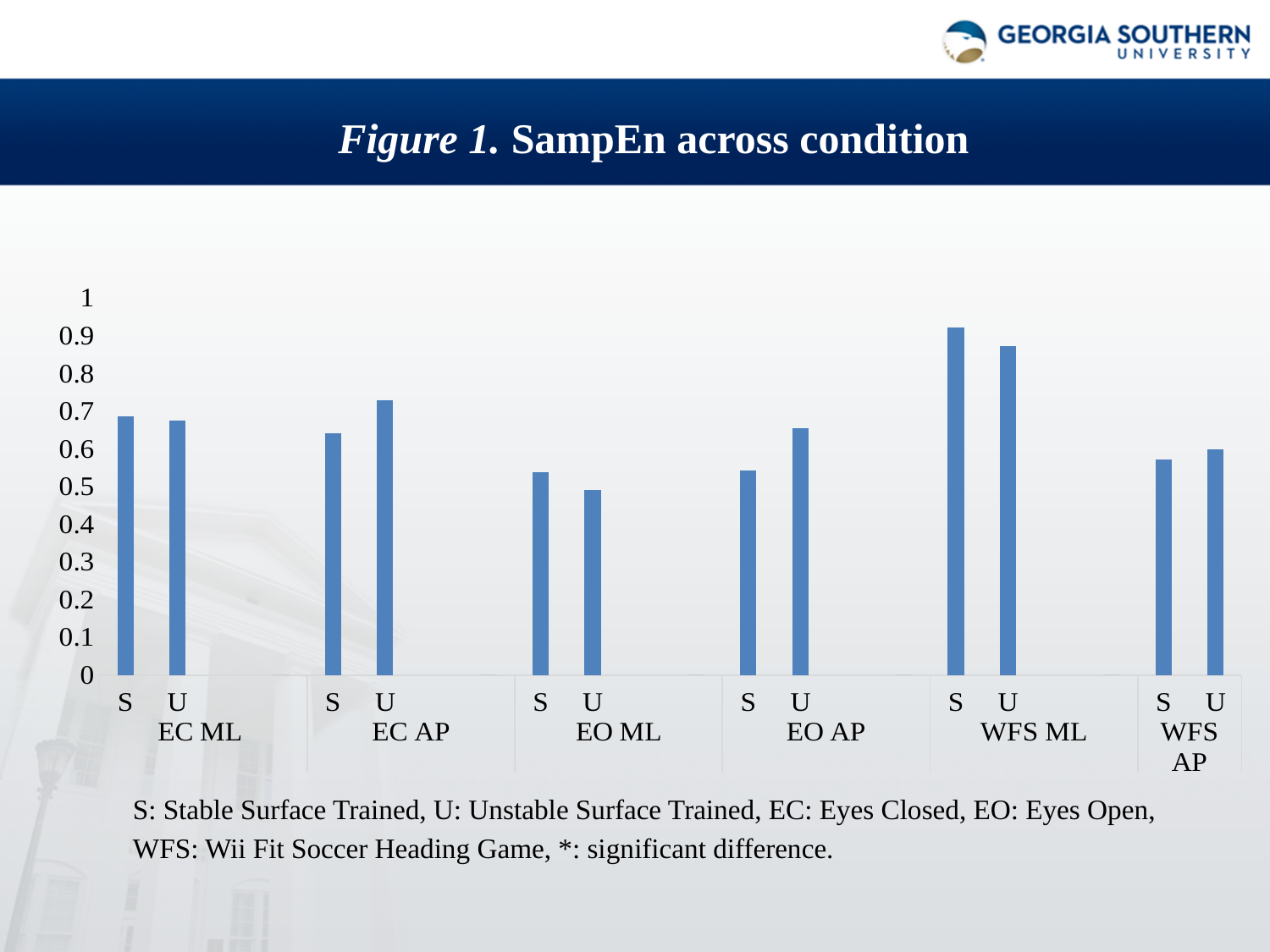
Is the value for EC AP U greater or less than 0.6? greater According to the note below the chart, what does S stand for? Stable Surface Trained How many bars are plotted in the chart? 12 Which bar has the lowest SampEn value? EO ML U Which bar has the highest SampEn value? WFS ML S Within the EC AP condition, which is larger, S or U? U Within the EO AP condition, which is larger, S or U? U Is the value for WFS ML S greater or less than 0.8? greater Is the value for EO ML U greater or less than 0.6? less What kind of chart is shown on the slide? Bar chart What is the title of the chart? Figure 1. SampEn across condition How many condition groups (EC ML, EC AP, etc.) are shown along the x axis? 6